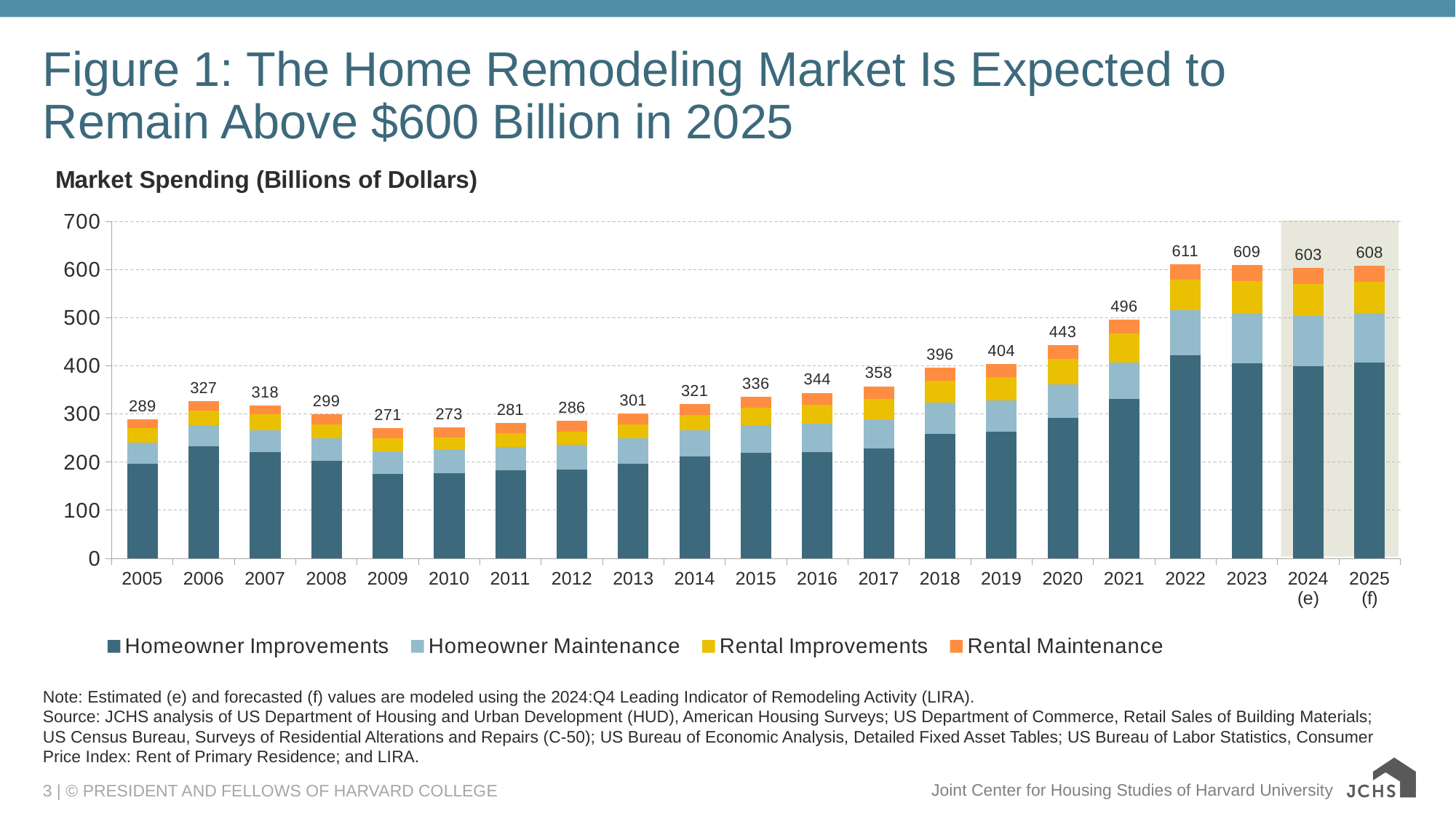
Do the total values rise or fall from 2009 to 2022? Rise What is the forecasted total market spending for 2025 (f)? 608 Which year has the lowest total market spending? 2009 What kind of chart is shown? Stacked bar chart What is the difference between the total for 2022 and the total for 2021? 115 Which year has the highest total market spending? 2022 Is the Homeowner Improvements value for 2022 greater or less than 400? greater How many years are shown on the x axis? 21 How many series does the legend list? 4 Which year has a larger total, 2006 or 2007? 2006 What is the total market spending shown for 2009? 271 What is the total market spending shown for 2022? 611